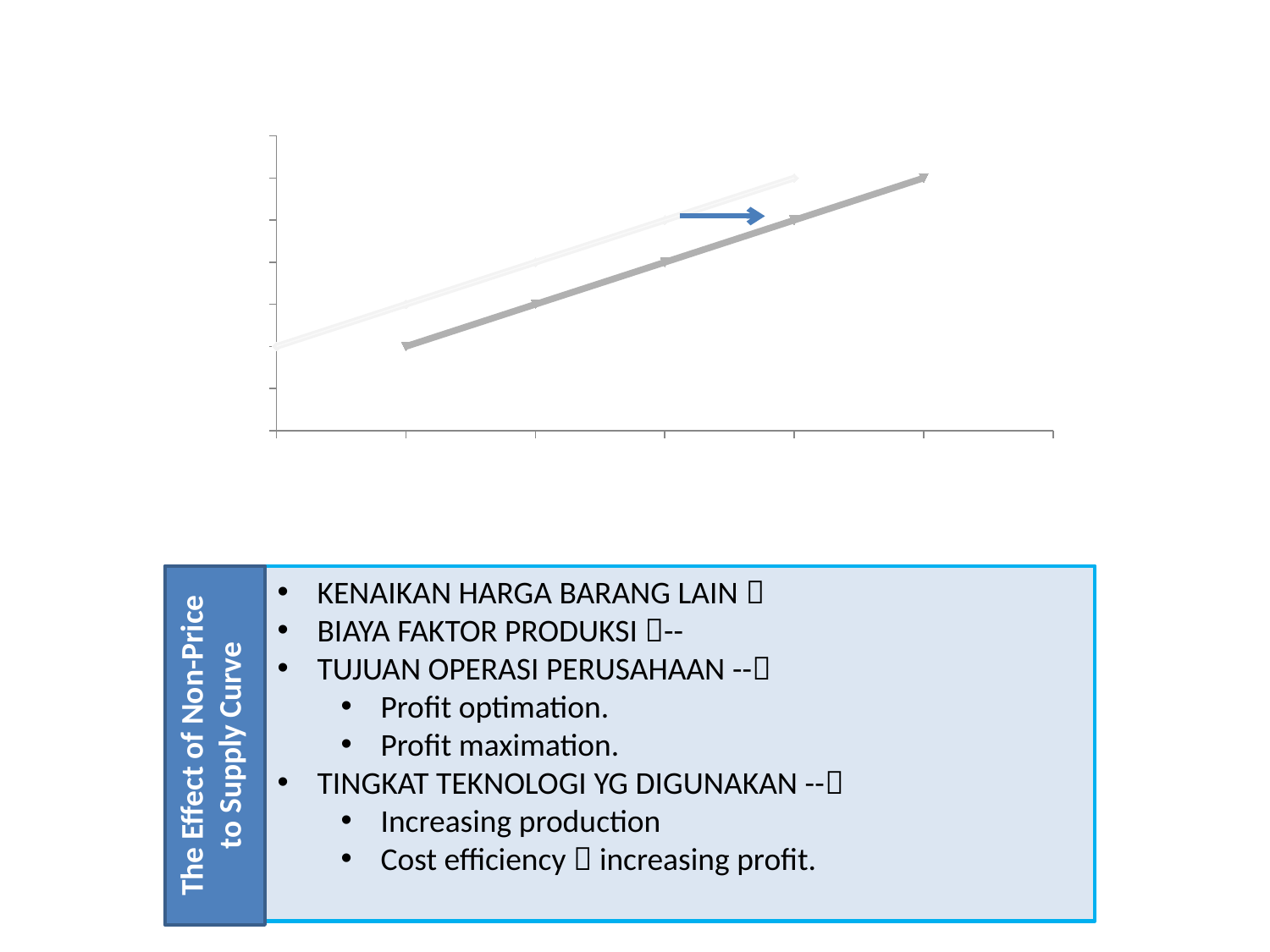
How many lines are plotted on the chart? 2 In which direction does the blue arrow between the two lines point? to the right Does the chart display a legend? No Do the plotted lines rise or fall from left to right along the x axis? rise What kind of chart is shown on the slide? line chart